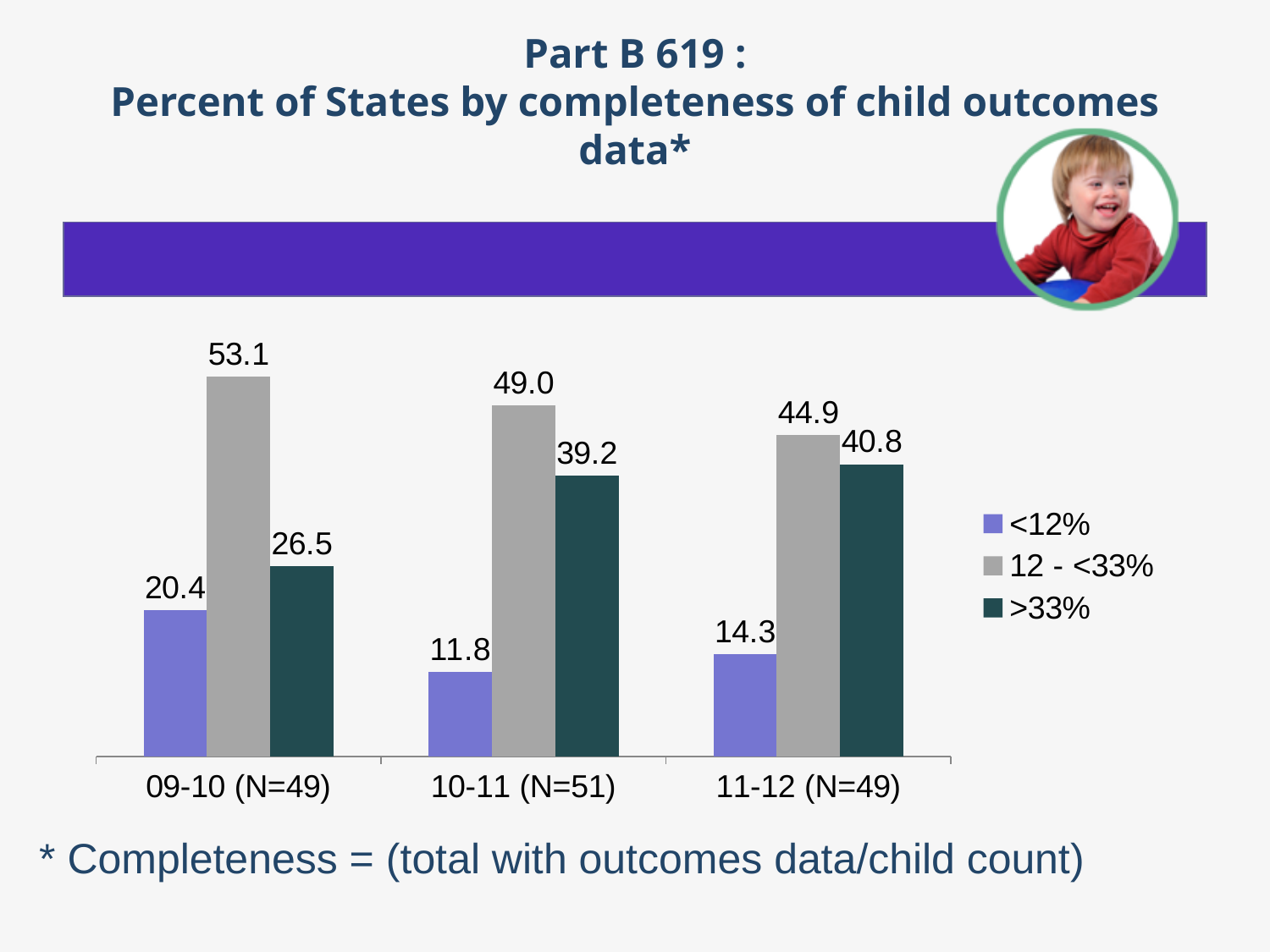
Which is larger in 09-10 (N=49): the <12% value or the >33% value? >33% Does the 12 - <33% series rise or fall from 09-10 to 11-12? fall What is the difference between the 12 - <33% value and the >33% value in 11-12 (N=49)? 4.1 What is the value for the <12% series in 11-12 (N=49)? 14.3 Which year group has the highest value for the >33% series? 11-12 (N=49) What is the value for the 12 - <33% series in 09-10 (N=49)? 53.1 What kind of chart is shown on the slide? bar chart Which year group has the lowest value for the <12% series? 10-11 (N=51) Which legend entry is shown in dark teal? >33% How many year groups are shown on the x axis? 3 How many series does the legend list? 3 What is the value for the >33% series in 10-11 (N=51)? 39.2